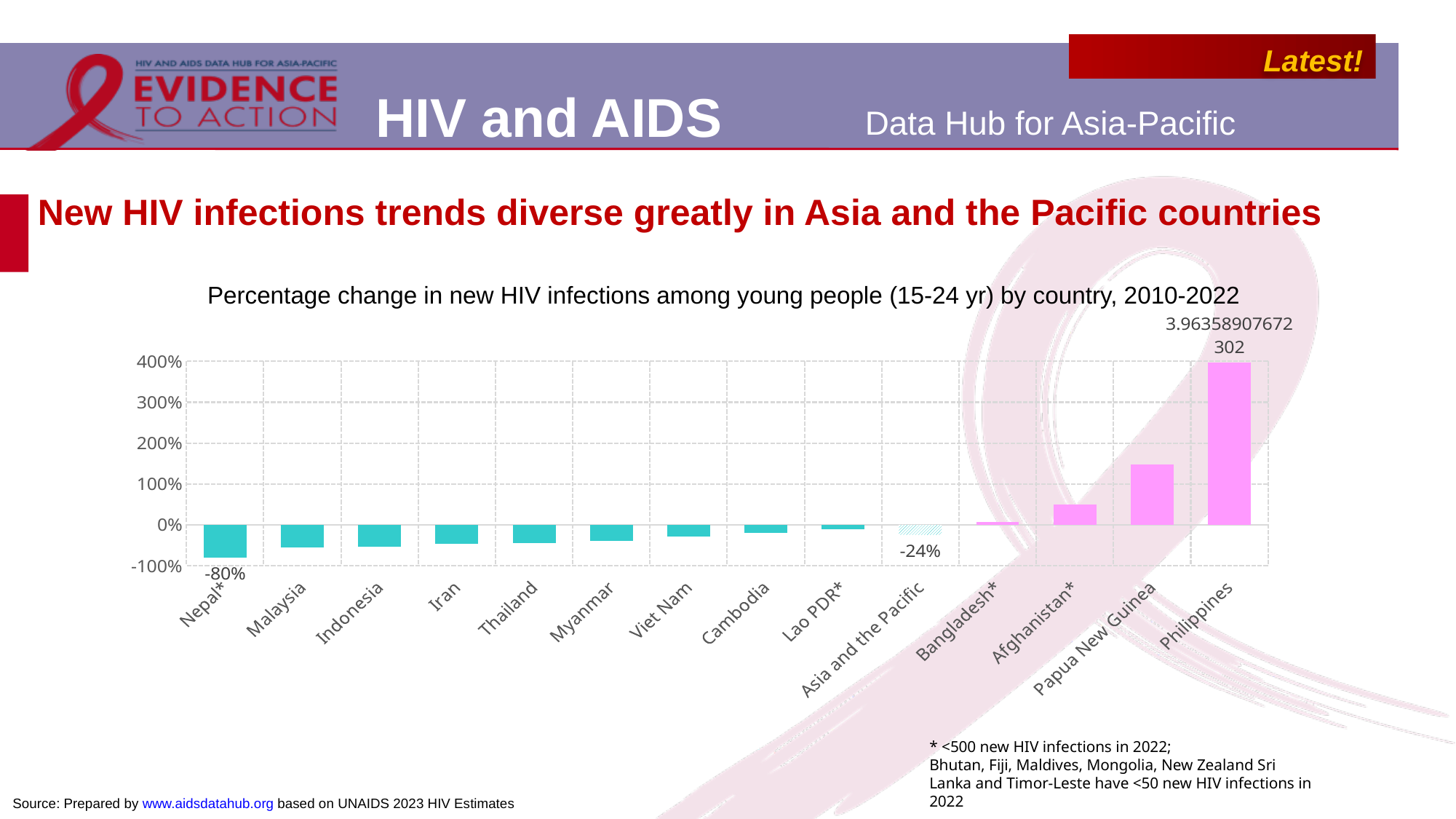
What is the difference in percentage points between the values for Nepal* (-80%) and Asia and the Pacific (-24%)? 56 percentage points Do the values generally rise or fall moving from left to right along the x axis? Rise Which country has the lowest (most negative) percentage change in new HIV infections among young people? Nepal* How many countries/regions are plotted on the chart? 14 Is the value for Papua New Guinea greater or less than 100%? greater What kind of chart is used to show the percentage change in new HIV infections? Bar chart Which country has the highest percentage change in new HIV infections among young people? Philippines What is the title of the chart? Percentage change in new HIV infections among young people (15-24 yr) by country, 2010-2022 Is the value for Afghanistan* greater or less than 100%? less Which has the larger decline in new HIV infections, Nepal* or Malaysia? Nepal* What is the percentage change in new HIV infections among young people shown for Nepal*? -80% What is the percentage change shown for Asia and the Pacific? -24%